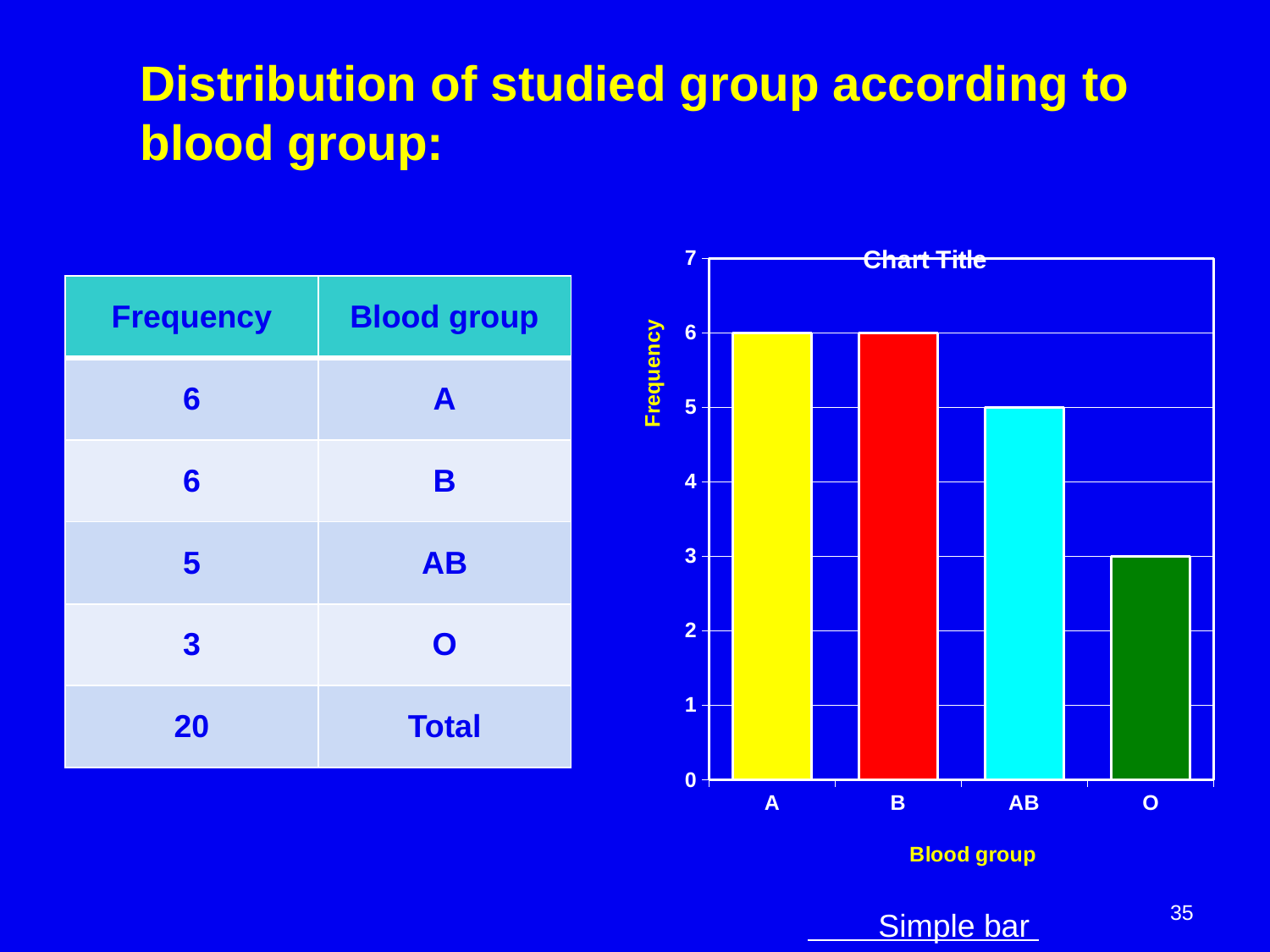
What is the difference in frequency between blood group AB and blood group O? 2 What is the frequency for blood group A in the bar chart? 6 How many blood group categories are shown on the x axis of the chart? 4 Which blood group has the lowest frequency in the bar chart? O What is the difference in frequency between blood group B and blood group AB? 1 What is the frequency for blood group AB in the bar chart? 5 Which has a higher frequency, blood group AB or blood group O? AB What is the label of the vertical axis of the chart? Frequency Is the frequency for blood group O greater or less than 4? less What kind of chart is shown on the slide? bar chart What colour is the bar for blood group B? red What is the frequency for blood group O in the bar chart? 3